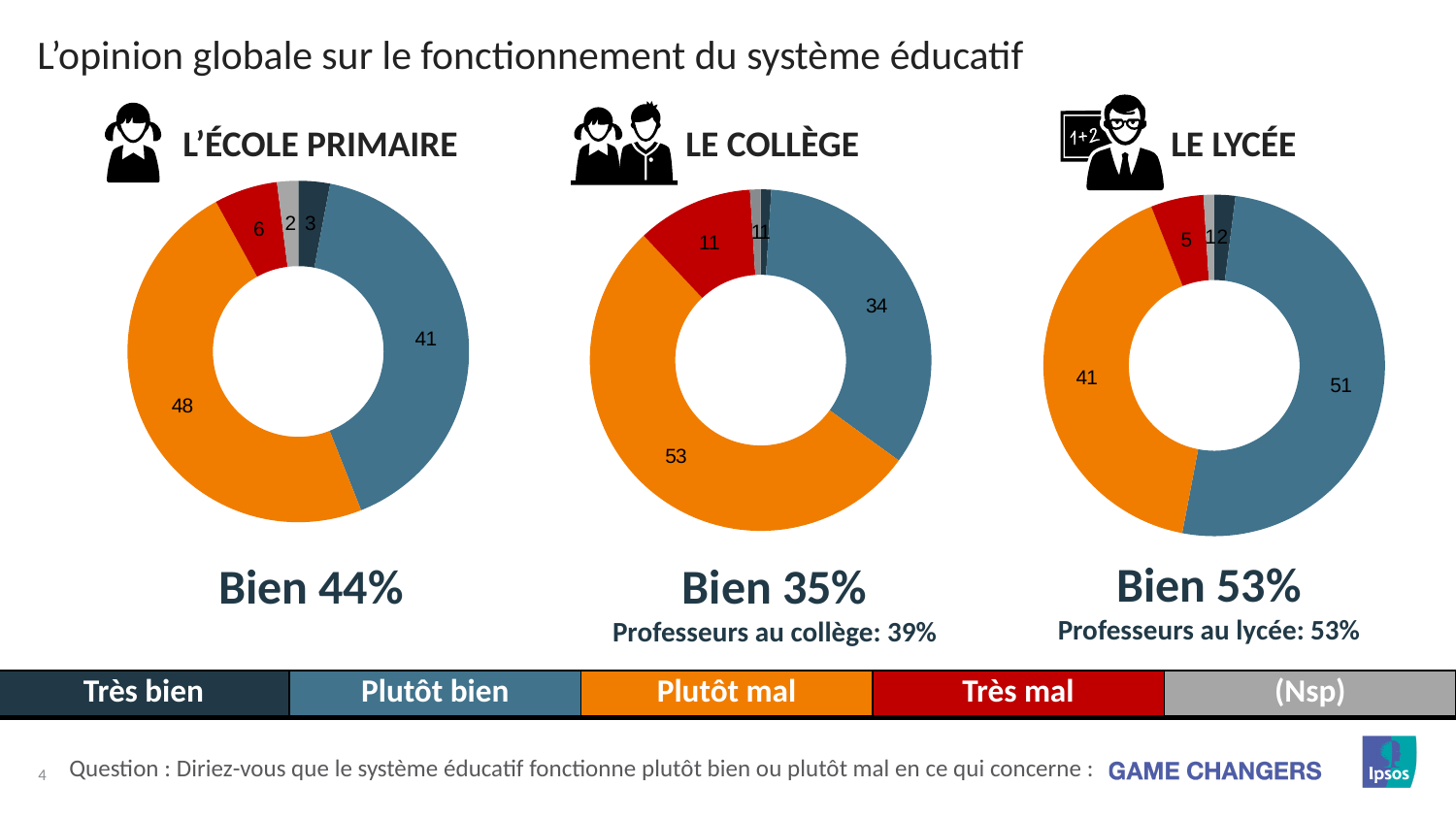
In the 'LE COLLÈGE' chart, which category has the largest slice? Plutôt mal In the 'LE LYCÉE' chart, what is the value for 'Plutôt bien'? 51 In the 'LE LYCÉE' chart, which category has the largest slice? Plutôt bien In the 'L'ÉCOLE PRIMAIRE' chart, what is the difference between 'Plutôt mal' and 'Plutôt bien'? 7 In the 'L'ÉCOLE PRIMAIRE' chart, what is the value for 'Plutôt mal'? 48 What kind of chart is used for 'LE COLLÈGE'? Donut (pie) chart In the 'LE COLLÈGE' chart, what is the value for 'Plutôt bien'? 34 How many categories does the legend at the bottom of the slide list? 5 In the 'L'ÉCOLE PRIMAIRE' chart, which category has the largest slice? Plutôt mal What colour represents 'Très mal' in the charts? Red In the 'LE COLLÈGE' chart, what is the value for 'Très mal'? 11 In the 'LE LYCÉE' chart, which is larger, 'Plutôt bien' or 'Plutôt mal'? Plutôt bien